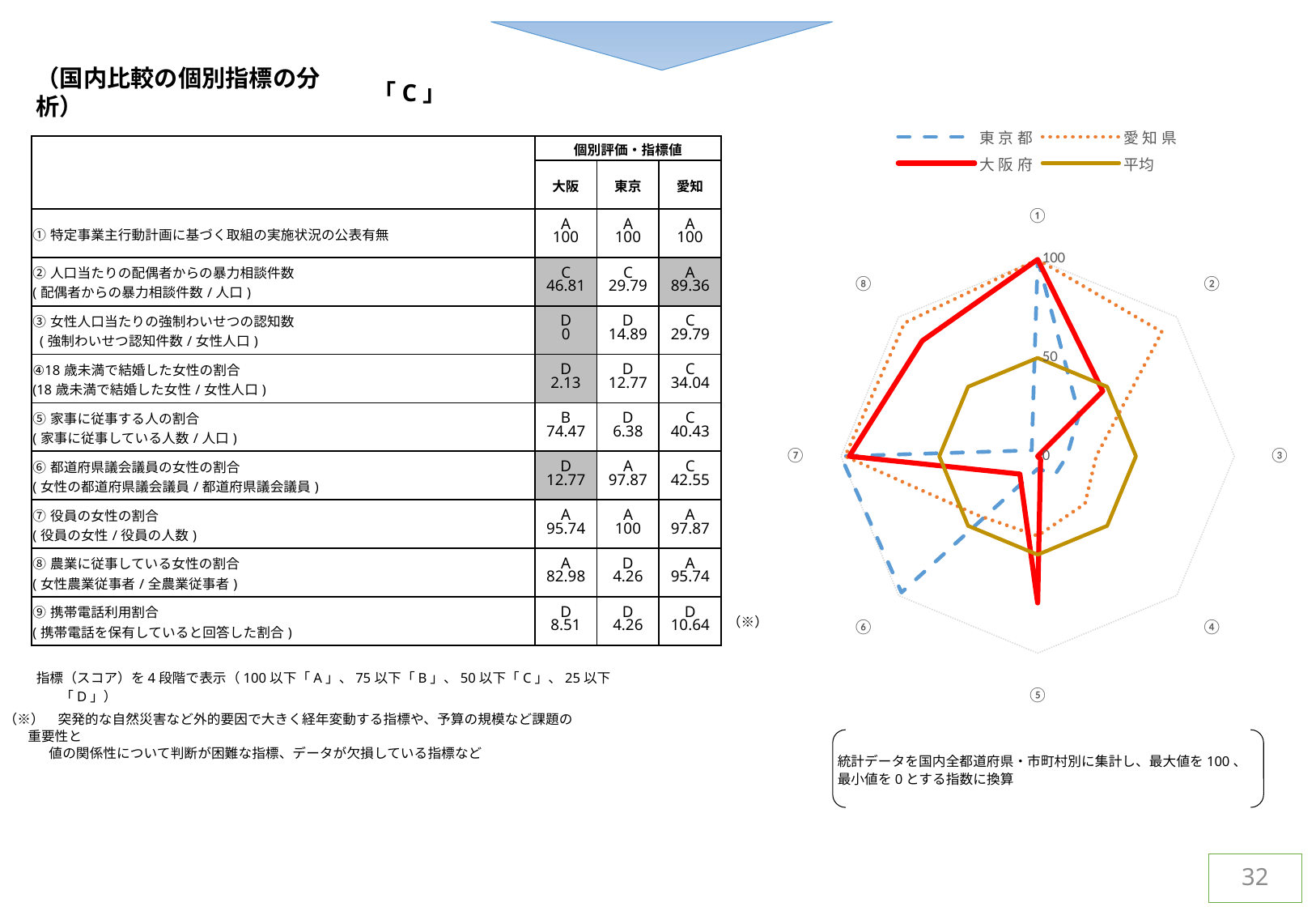
On the radar chart, is the value for 愛知県 on axis ② greater or less than 50? greater Which of the three prefectures has the highest value on item ⑥ 都道府県議会議員の女性の割合? 東京 On item ③ 女性人口当たりの強制わいせつの認知数, which is larger, the value for 愛知 or for 東京? 愛知 On the radar chart, is the value for 大阪府 on axis ⑦ greater or less than 50? greater According to the table, what is the indicator value for 大阪 on item ⑤ 家事に従事する人の割合? 74.47 Which of the three prefectures has the lowest value on item ⑤ 家事に従事する人の割合? 東京 Which series in the radar chart is drawn as a solid red line? 大阪府 On the radar chart, is the value for 東京都 on axis ⑧ greater or less than 50? less What is the difference between the 大阪 and 東京 values on item ⑧ 農業に従事している女性の割合? 78.72 How many axes (indicators) does the radar chart have? 8 What kind of chart is shown on the right side of the slide? radar chart How many series does the legend of the radar chart list? 4